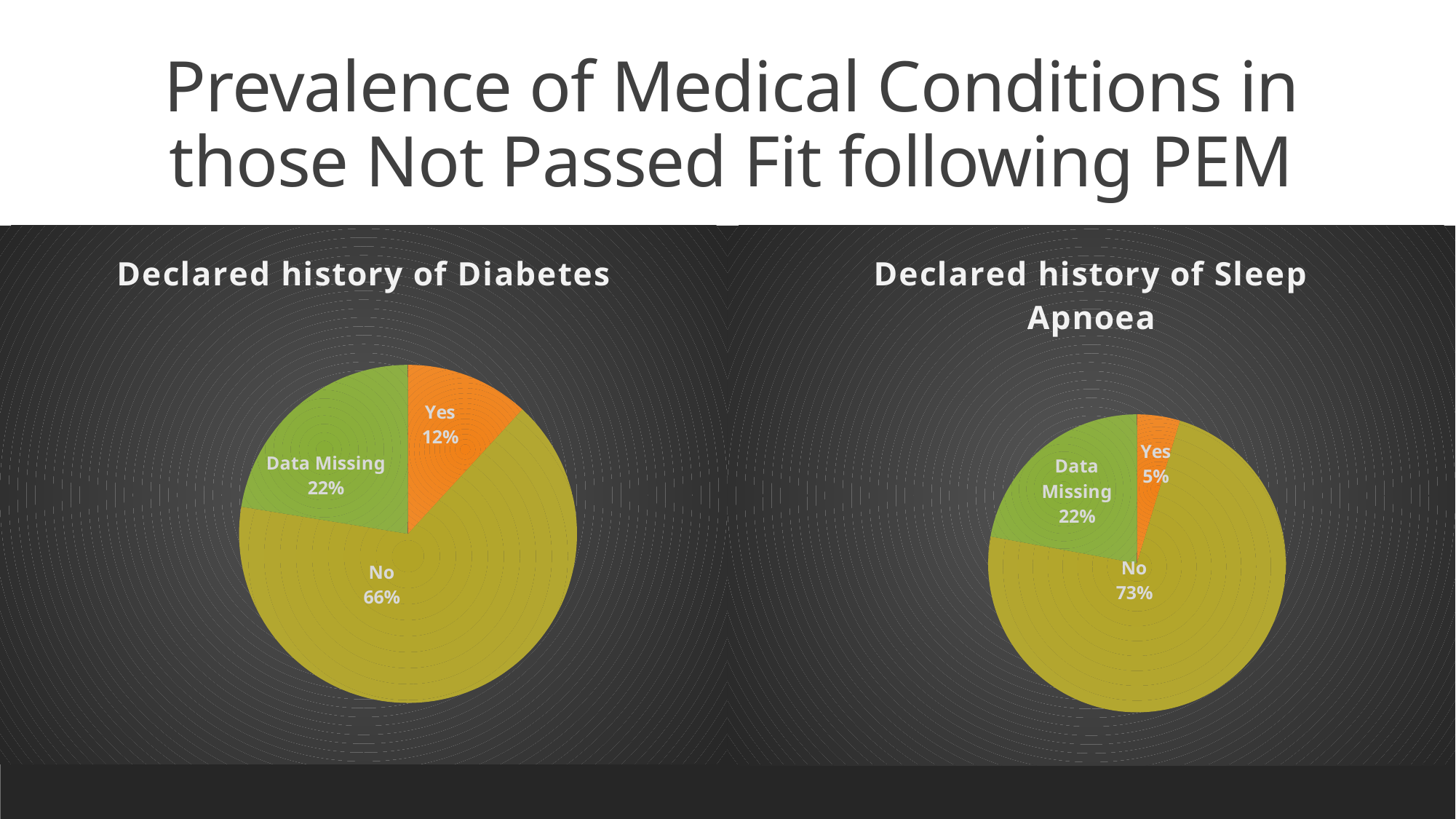
In the 'Declared history of Sleep Apnoea' chart, what percentage is labelled 'Yes'? 5% What is the title of the chart on the right side of the slide? Declared history of Sleep Apnoea In the 'Declared history of Diabetes' chart, which slice is the largest? No In the 'Declared history of Diabetes' chart, what is the difference in percentage points between the 'No' and 'Data Missing' slices? 44 How many slices does the 'Declared history of Sleep Apnoea' chart have? 3 In the 'Declared history of Sleep Apnoea' chart, which slice is the smallest? Yes In the 'Declared history of Sleep Apnoea' chart, what percentage is labelled 'No'? 73% In the 'Declared history of Diabetes' chart, what share of the pie does the 'No' slice represent? 66% Which chart has the larger 'Yes' slice, 'Declared history of Diabetes' or 'Declared history of Sleep Apnoea'? Declared history of Diabetes In the 'Declared history of Diabetes' chart, what percentage is labelled 'Yes'? 12% What type of chart is the 'Declared history of Diabetes' chart? Pie chart In the 'Declared history of Diabetes' chart, what percentage is labelled 'Data Missing'? 22%